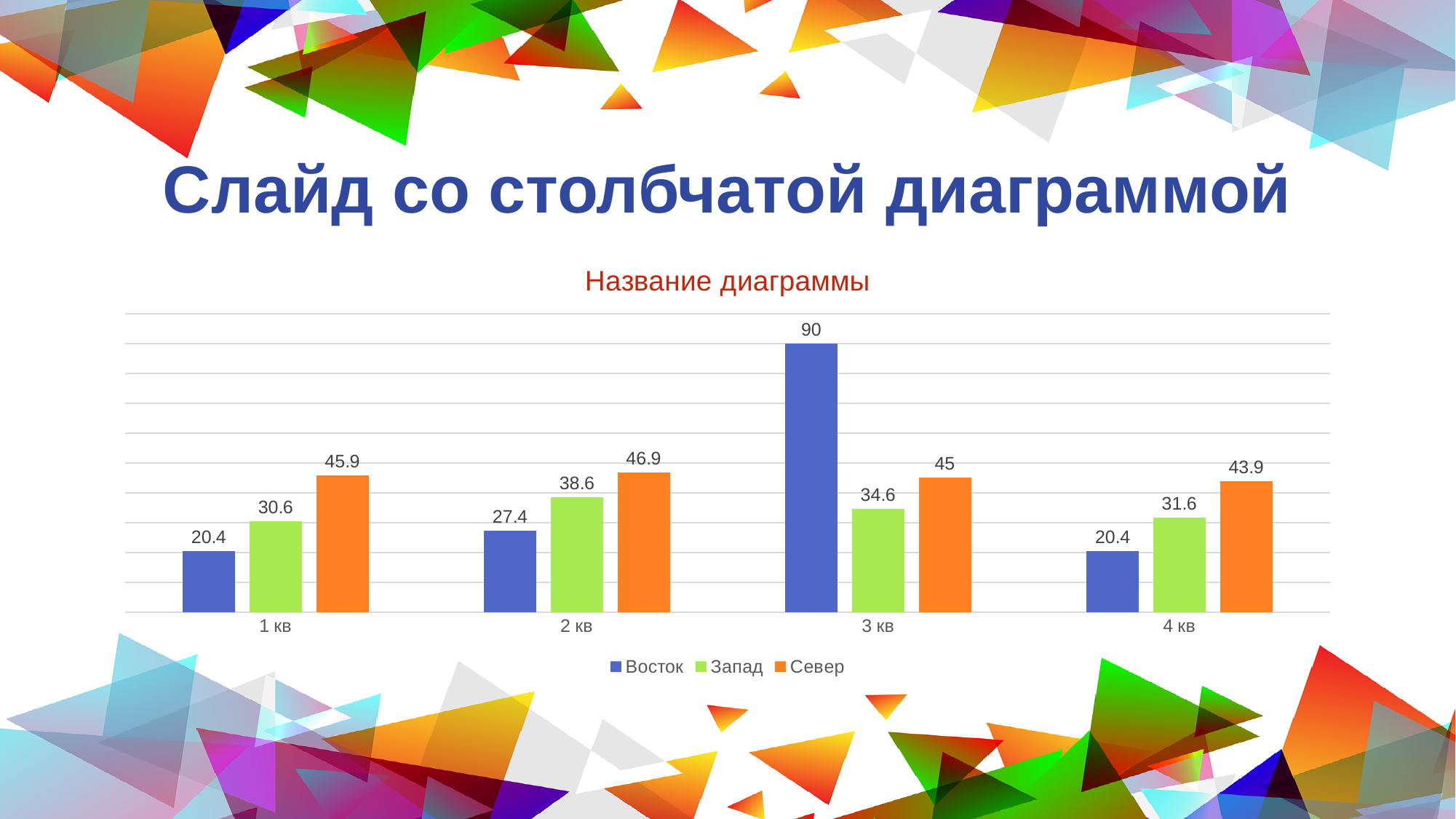
What is the title of the chart? Название диаграммы Which colour represents the Север series? orange What is the value for Север in 2 кв? 46.9 Which category has the lowest value for Запад? 1 кв What kind of chart is shown on the slide? bar chart What is the difference between Север and Восток in 1 кв? 25.5 How many series does the legend list? 3 How many categories are shown on the x axis? 4 Which is larger in 2 кв: Запад or Север? Север Which category has the highest value for Восток? 3 кв What is the value for Восток in 3 кв? 90 What is the value for Запад in 4 кв? 31.6